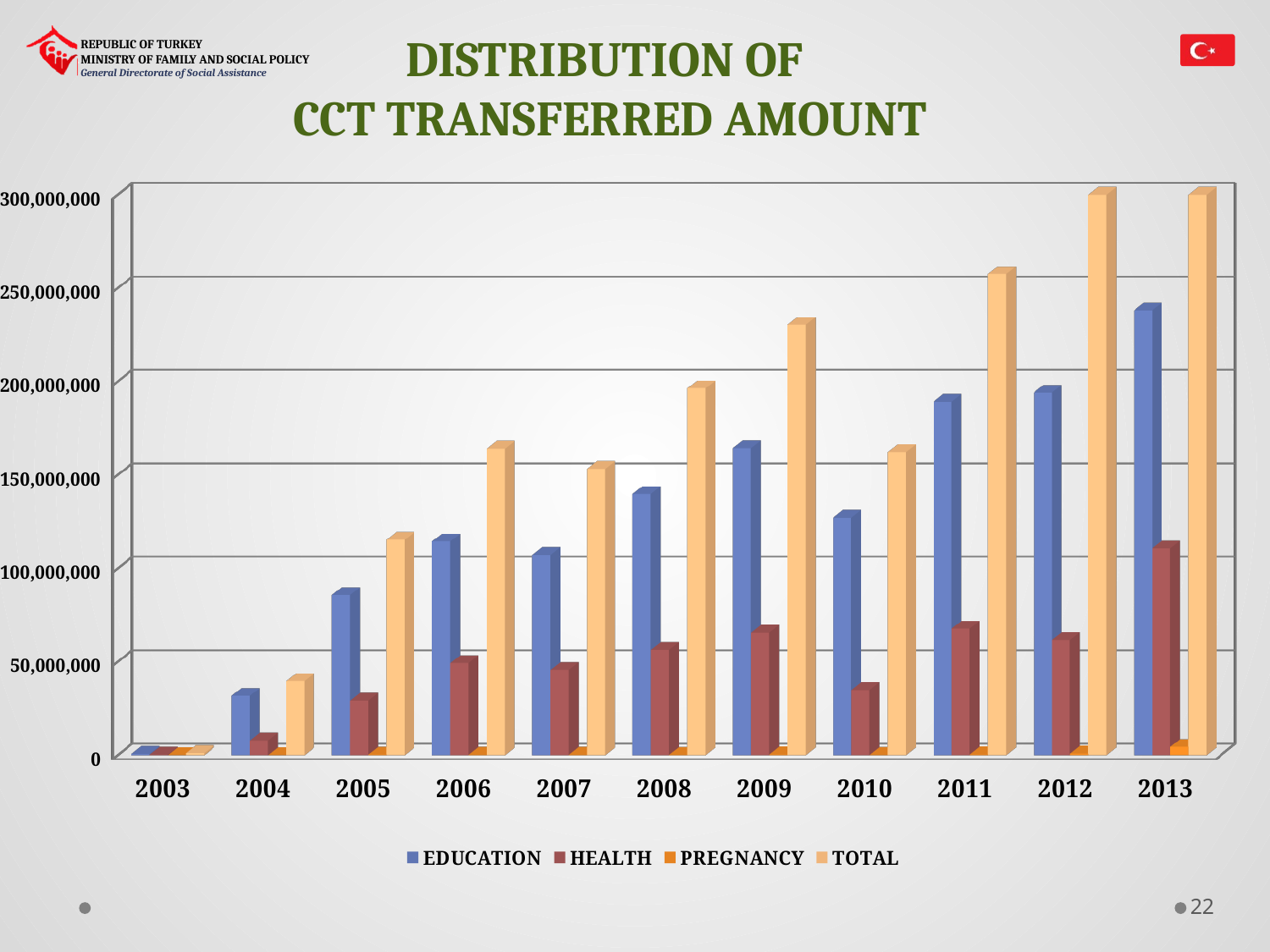
What colour represents the PREGNANCY series in the legend? orange Is the EDUCATION value for 2013 greater or less than 200,000,000? greater Which year has the highest EDUCATION value? 2013 Which year has the highest HEALTH value? 2013 Which year has the lowest TOTAL value? 2003 Which year has the larger TOTAL value, 2009 or 2010? 2009 Is the TOTAL value for 2009 greater or less than 250,000,000? less How many years are shown on the x axis of the chart? 11 Overall, do the TOTAL values rise or fall from 2003 to 2013? rise Is the HEALTH value for 2013 greater or less than 100,000,000? greater How many series does the chart's legend list? 4 What kind of chart is shown on the slide? bar chart